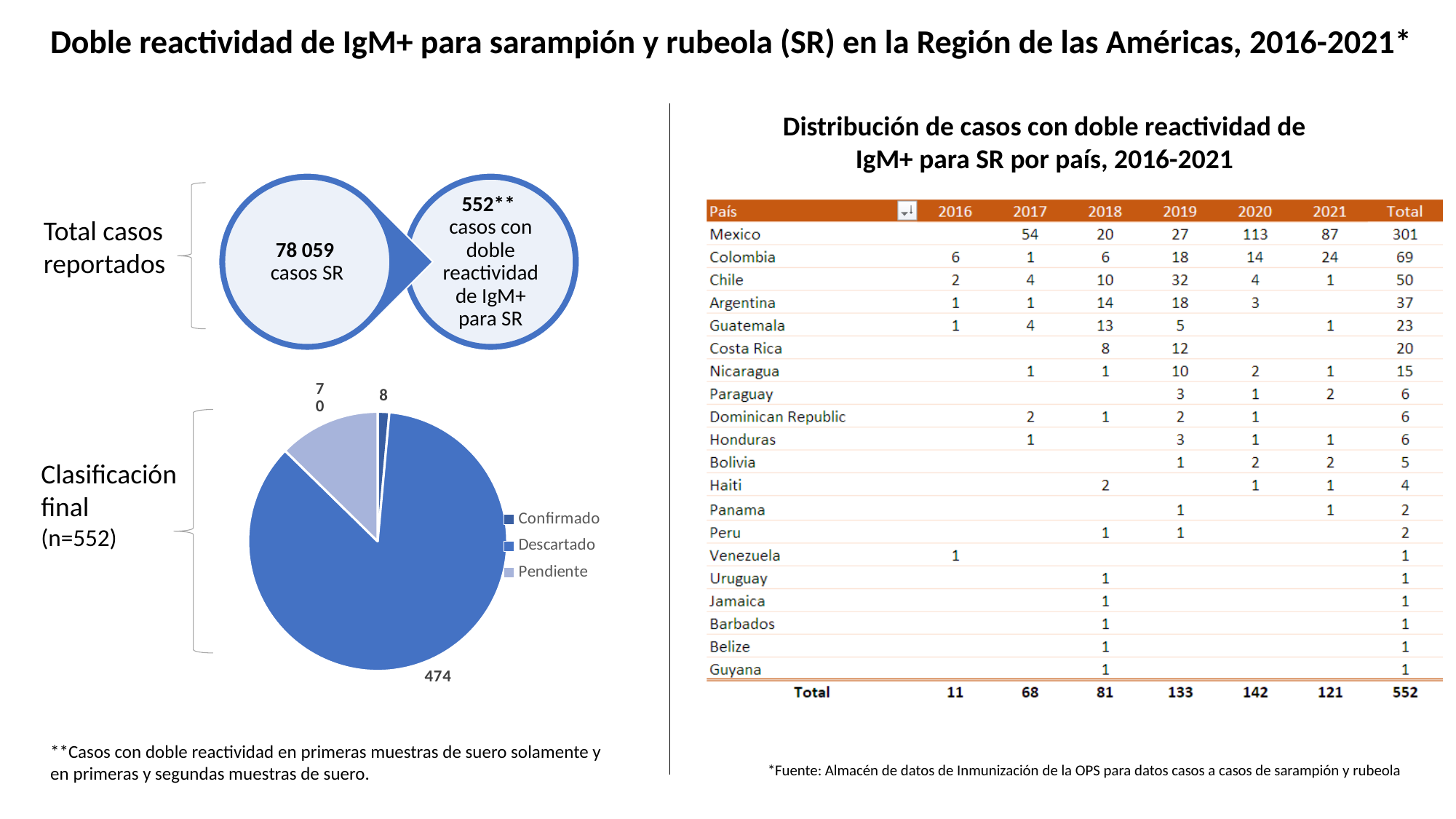
In the 'Clasificación final' pie chart, what is the value for Pendiente? 70 In the 'Clasificación final' pie chart, what is the value for Descartado? 474 In the 'Clasificación final' pie chart, what share of the total does the Descartado slice represent? 85.9% How many entries does the legend of the 'Clasificación final' pie chart list? 3 In the 'Clasificación final' pie chart, what is the value for Confirmado? 8 How many slices does the 'Clasificación final' pie chart have? 3 What are the legend entries of the 'Clasificación final' pie chart? Confirmado, Descartado, Pendiente What kind of chart is used for the 'Clasificación final (n=552)' figure? pie chart In the 'Clasificación final' pie chart, which category has the largest slice? Descartado In the 'Clasificación final' pie chart, which is larger, Pendiente or Confirmado? Pendiente In the 'Clasificación final' pie chart, which category has the smallest slice? Confirmado In the 'Clasificación final' pie chart, what is the difference between the Descartado and Pendiente values? 404